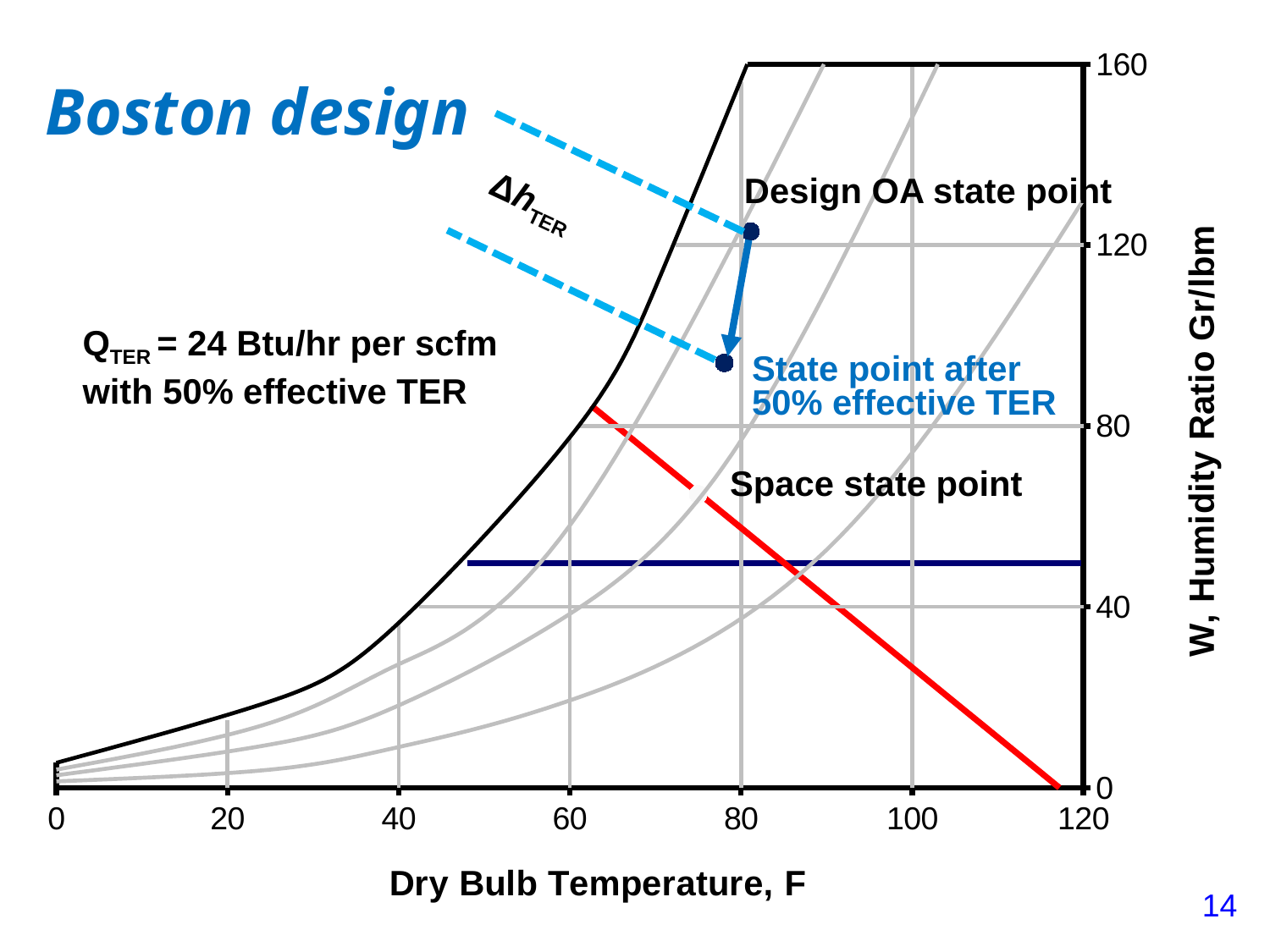
Is the humidity ratio of the state point after 50% effective TER greater or less than 80? greater Does the red line rise or fall as dry bulb temperature increases? fall What kind of chart is shown on the slide? line chart What is the title of the slide containing the chart? Boston design Is the humidity ratio of the state point after 50% effective TER greater or less than 120? less What value of Q_TER is stated on the slide? 24 Btu/hr per scfm Which has the higher humidity ratio: the Design OA state point or the state point after 50% effective TER? Design OA state point Is the humidity ratio of the Design OA state point greater or less than 80? greater How many labeled state points are marked on the chart? 3 What is the highest value shown on the y axis (W, Humidity Ratio Gr/lbm)? 160 What is the highest value shown on the x axis (Dry Bulb Temperature, F)? 120